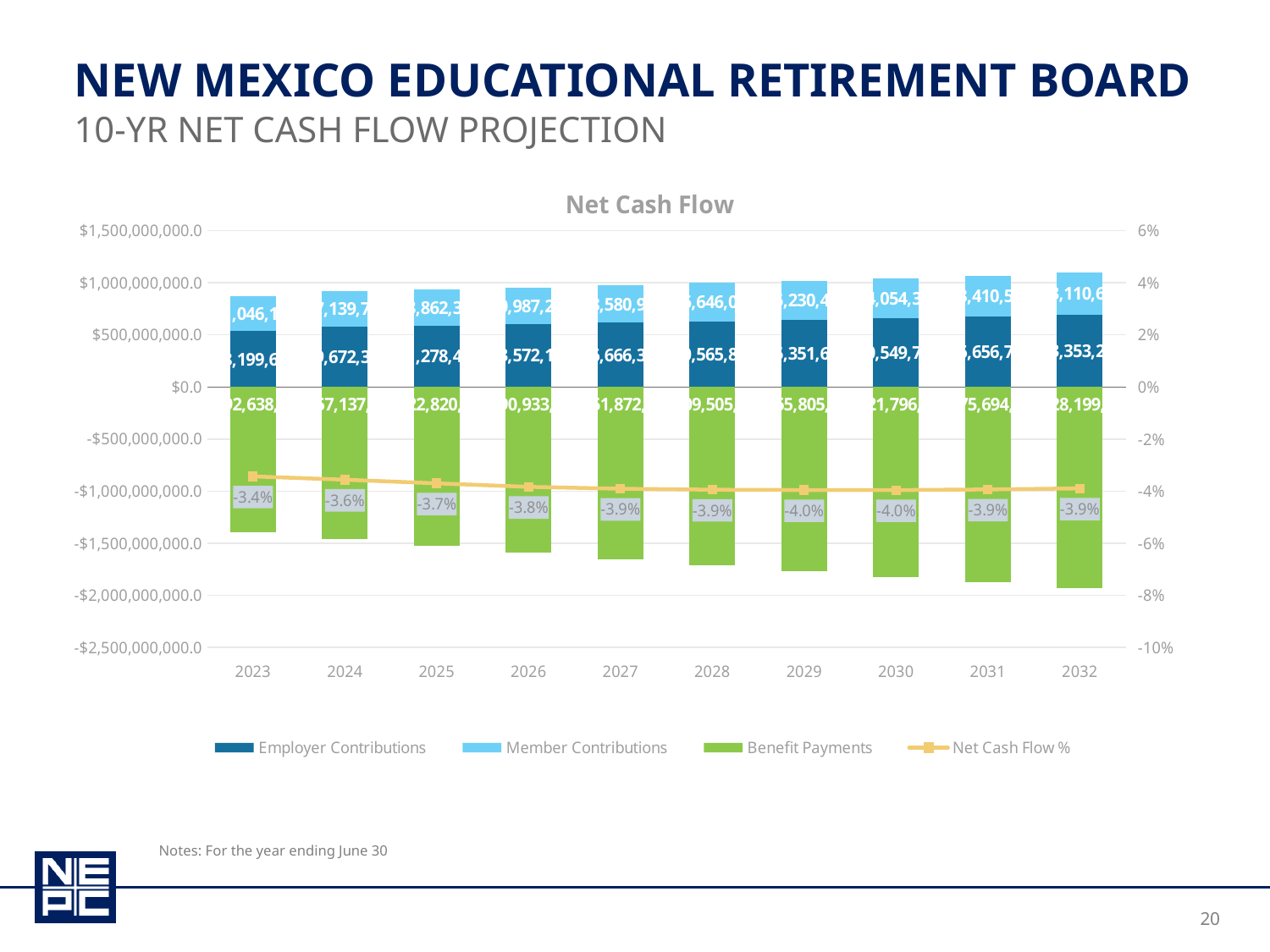
What is the Net Cash Flow % for 2030? -4.0% Is the Benefit Payments value for 2023 greater or less than -$1,000,000,000? less Which year has a higher Net Cash Flow %, 2024 or 2027? 2024 What is the difference between the Net Cash Flow % in 2023 and in 2029? 0.6 percentage points How many years are shown on the x axis of the chart? 10 What is the Net Cash Flow % for 2026? -3.8% How many series does the chart's legend list? 4 Is the Benefit Payments value for 2032 greater or less than -$1,500,000,000? less Which year has the highest (least negative) Net Cash Flow %? 2023 Does the Net Cash Flow % line generally rise or fall from 2023 to 2029? Fall What is the Net Cash Flow % for 2023? -3.4% What kind of chart is used to show the contributions and benefit payments? Bar chart (stacked), with a line for Net Cash Flow %